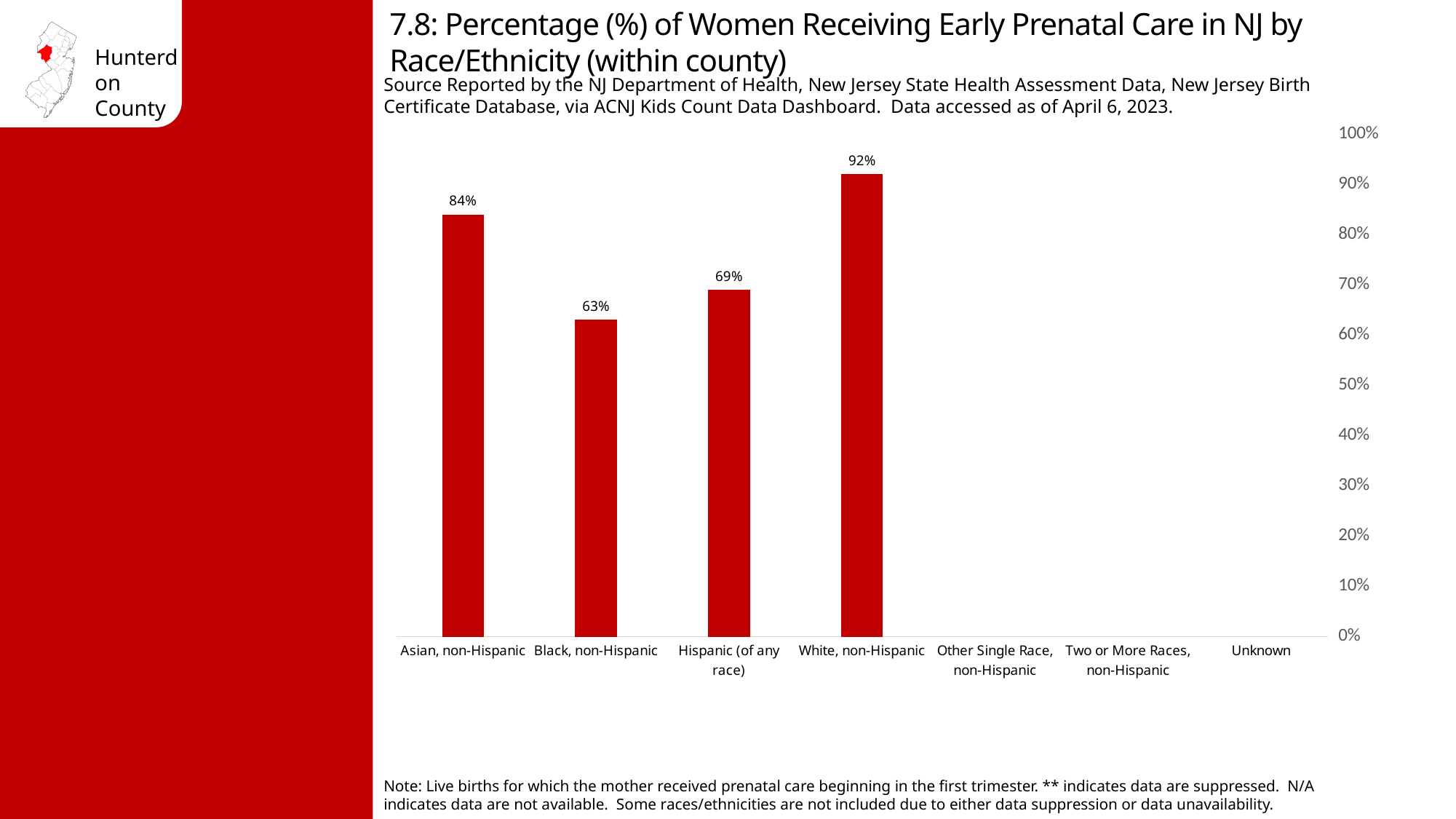
Which is larger, the value for Asian, non-Hispanic or the value for Hispanic (of any race)? Asian, non-Hispanic What percentage of Black, non-Hispanic women received early prenatal care? 63% How many race/ethnicity categories are labeled on the x axis? 7 What is the difference in percentage points between Asian, non-Hispanic and Hispanic (of any race)? 15 What is the value shown for White, non-Hispanic? 92% What is the value shown for Hispanic (of any race)? 69% Which race/ethnicity group has the highest percentage of women receiving early prenatal care? White, non-Hispanic What percentage of Asian, non-Hispanic women received early prenatal care? 84% Which race/ethnicity group with a plotted bar has the lowest percentage? Black, non-Hispanic How many categories have a bar plotted on the chart? 4 What is the difference in percentage points between White, non-Hispanic and Black, non-Hispanic? 29 What type of chart is shown on the slide? Bar chart